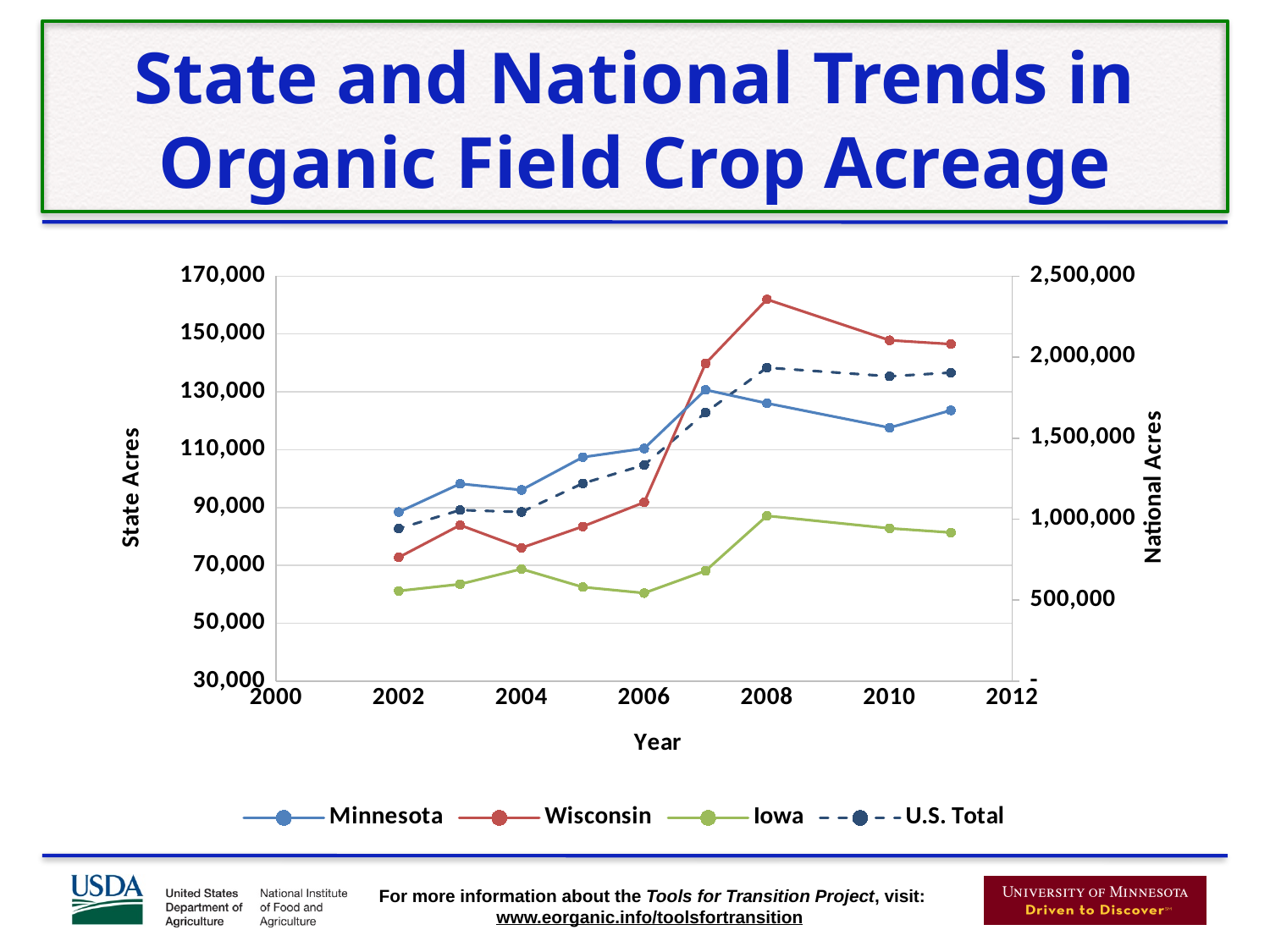
How many series does the legend list? 4 Which series is drawn with a dashed line? U.S. Total Which series has the highest value in 2008? U.S. Total Is the value for Wisconsin in 2008 greater or less than 150,000? greater In 2004, which is larger, the value for Minnesota or the value for Wisconsin? Minnesota Is the value for Minnesota in 2007 greater or less than 110,000? greater Is the value for Wisconsin in 2002 greater or less than 90,000? less What kind of chart is shown on the slide? line chart Does the Wisconsin series rise or fall from 2002 to 2008? rise What is the title of the left vertical axis? State Acres Which state series has the lowest value in 2011? Iowa